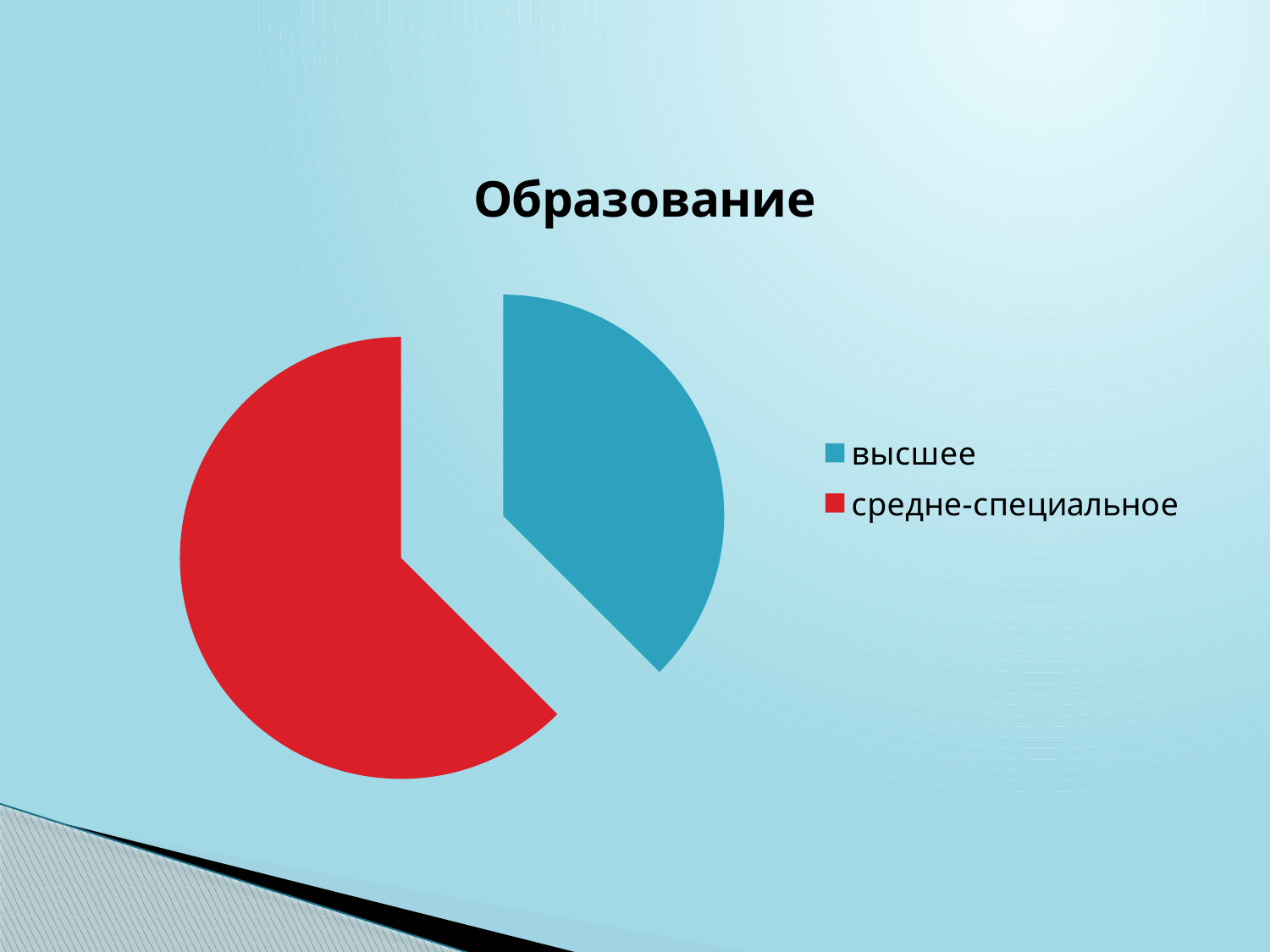
How many slices does the pie chart have? 2 Is the share of the pie for высшее greater or less than 50%? less What is the title of the chart? Образование Which category has the smallest slice of the pie? высшее Is the share of the pie for средне-специальное greater or less than 50%? greater Which slice is larger, высшее or средне-специальное? средне-специальное What kind of chart is shown on the slide? pie chart Which category has the largest slice of the pie? средне-специальное Which colour represents the category высшее in the chart? blue How many categories does the legend list? 2